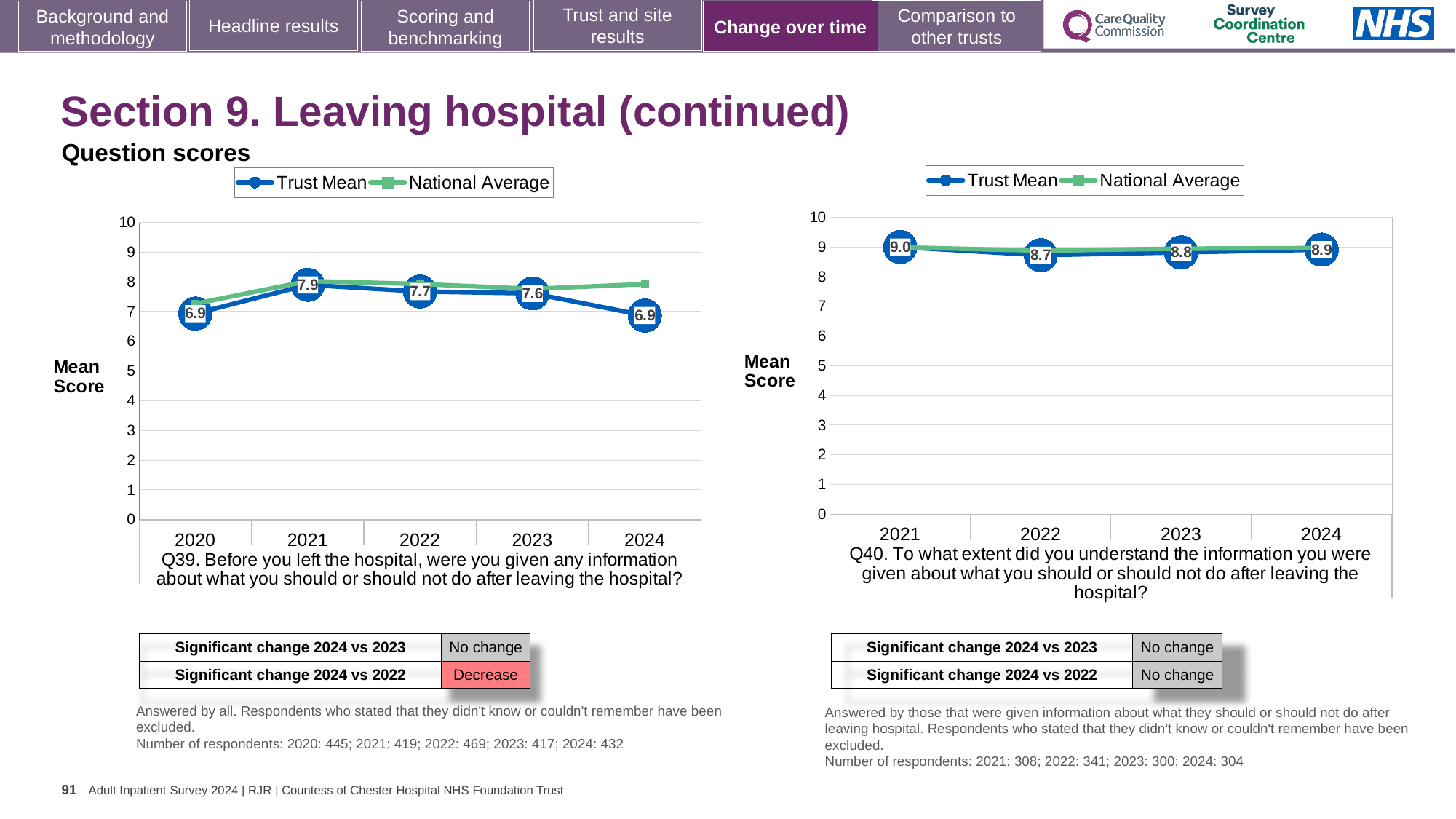
In the Q40 chart on the right, what is the Trust Mean score for 2022? 8.7 What type of chart is the Q40 chart on the right? Line chart In the Q40 chart on the right, which year has the lowest Trust Mean score? 2022 In the Q39 chart on the left, is the National Average value for 2024 greater or less than 7? greater In the Q39 chart on the left, what is the Trust Mean score for 2024? 6.9 In the Q39 chart on the left, does the Trust Mean score rise or fall from 2023 to 2024? fall In the Q39 chart on the left, which year has the highest Trust Mean score? 2021 How many series does the legend of the Q39 chart on the left list? 2 How many years are shown on the x axis of the Q40 chart on the right? 4 In the Q39 chart on the left, what is the difference between the Trust Mean scores for 2021 and 2024? 1.0 In the Q39 chart on the left, what is the Trust Mean score for 2021? 7.9 In the Q40 chart on the right, is the Trust Mean score for 2021 larger or smaller than the score for 2022? larger